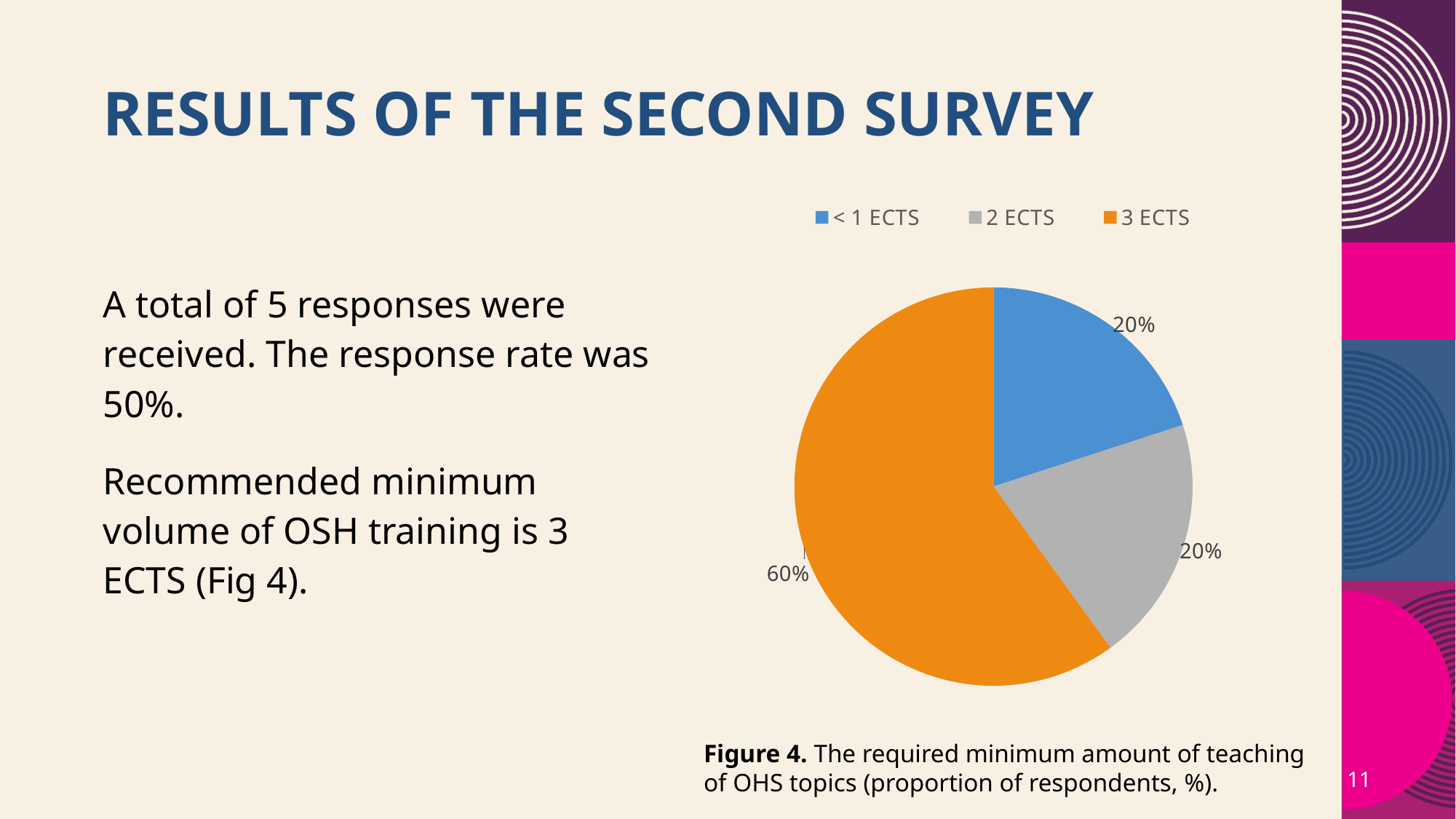
Which is larger, the slice for 3 ECTS or the slice for < 1 ECTS? 3 ECTS How many slices does the pie chart have? 3 What share of the pie does the < 1 ECTS slice represent? 20% What colour is the 3 ECTS slice? orange What share of the pie does the 3 ECTS slice represent? 60% Which category has the largest slice of the pie? 3 ECTS How many entries does the legend list? 3 What is the figure caption number of the chart? Figure 4 What share of the pie does the 2 ECTS slice represent? 20% What is the difference between the share for 3 ECTS and the share for 2 ECTS? 40% What kind of chart is shown on the slide? pie chart